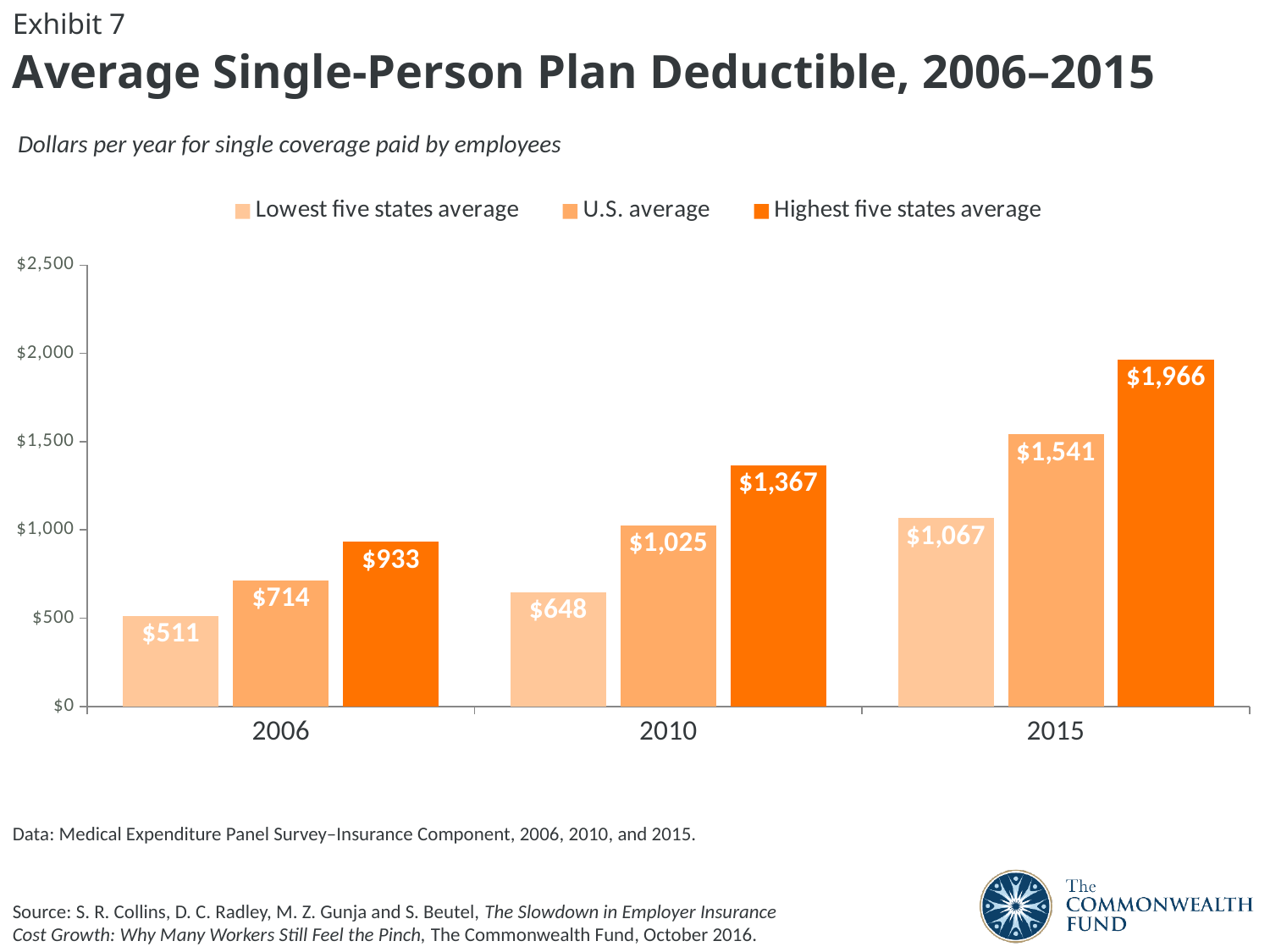
Which year has the highest U.S. average deductible? 2015 What is the lowest five states average deductible in 2006? $511 Which year has the lowest value for the highest five states average? 2006 What is the difference between the highest five states average and the lowest five states average in 2015? $899 What is the highest five states average deductible in 2015? $1,966 How many years are shown on the x axis? 3 Is the highest five states average in 2010 greater or less than $1,500? less What is the U.S. average single-person plan deductible in 2010? $1,025 How many series does the legend list? 3 Which is larger: the lowest five states average in 2015 or the U.S. average in 2010? Lowest five states average in 2015 What kind of chart is shown on the slide? Bar chart By how much did the U.S. average deductible increase from 2006 to 2015? $827